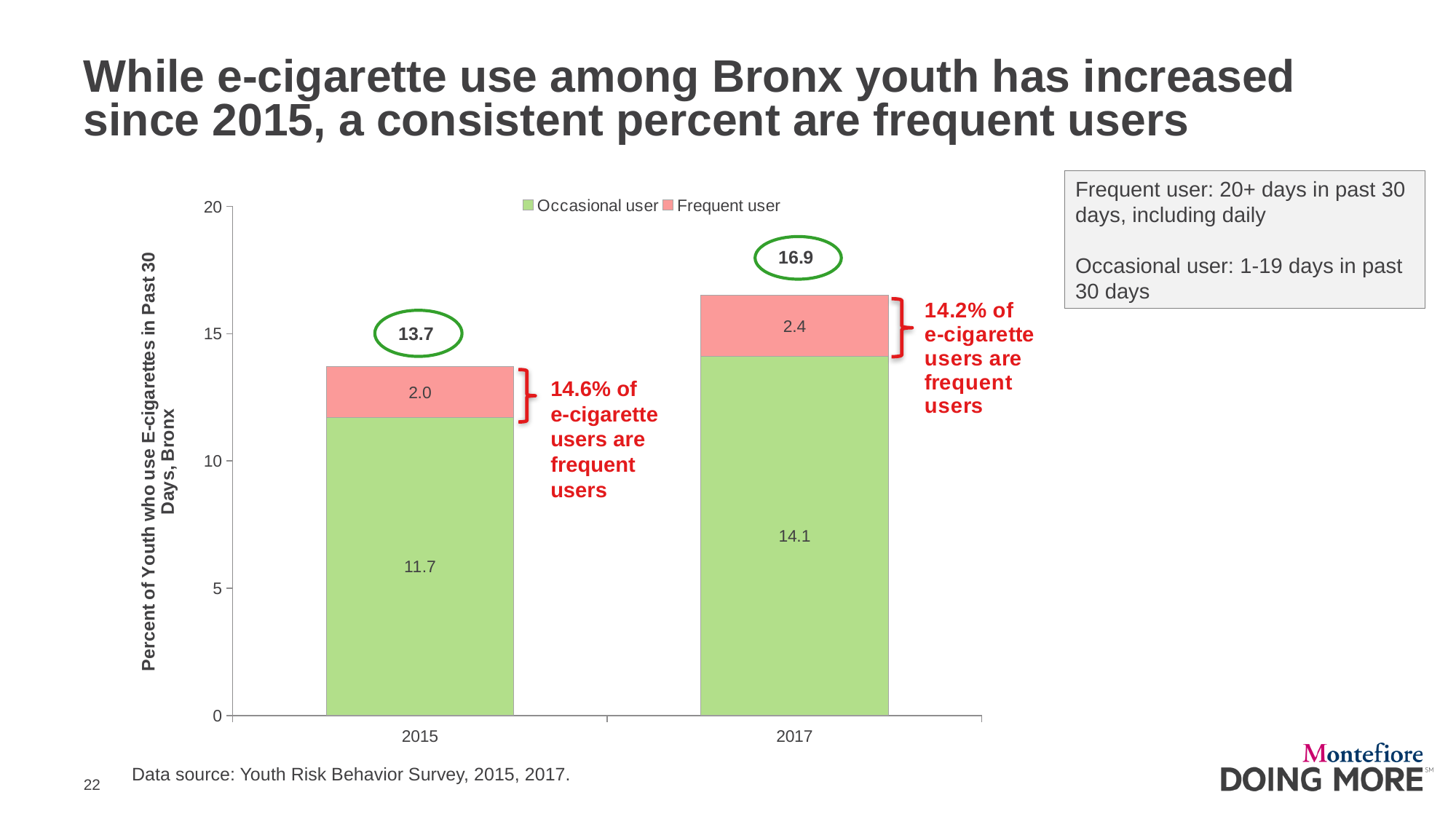
Does the total e-cigarette use rise or fall from 2015 to 2017? Rise What kind of chart is shown on the slide? Stacked bar chart Which year has the larger Frequent user value, 2015 or 2017? 2017 What is the value for Occasional user in 2017? 14.1 What is the value for Occasional user in 2015? 11.7 What total value is circled above the 2017 bar? 16.9 What is the value for Frequent user in 2015? 2.0 What is the difference between the Occasional user values for 2017 and 2015? 2.4 What is the total of the stacked bar for 2015? 13.7 What is the value for Frequent user in 2017? 2.4 How many years are shown on the x axis? 2 How many series does the legend list? 2